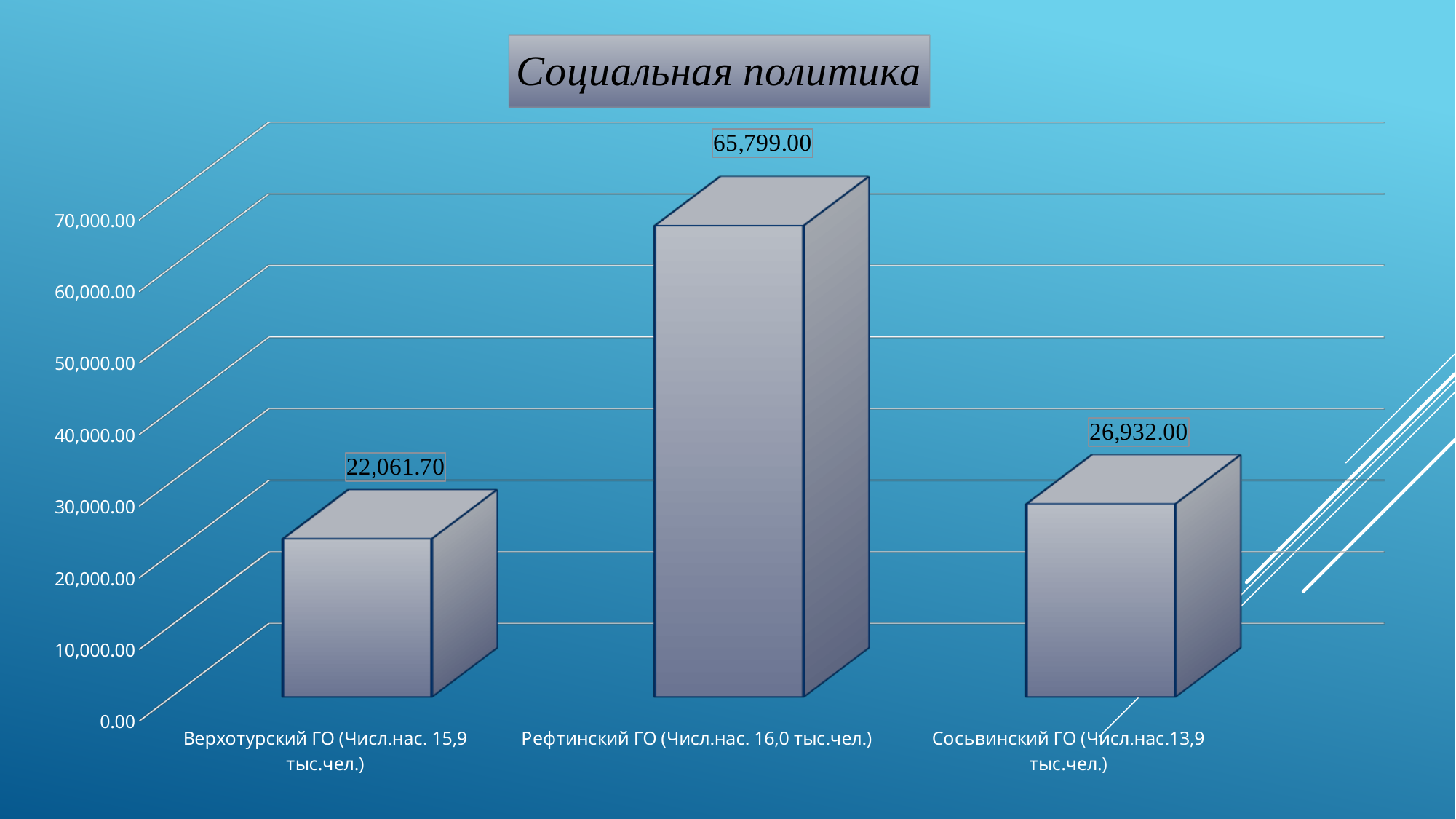
What kind of chart is shown on the slide? bar chart Which is larger, the value for Сосьвинский ГО or the value for Верхотурский ГО? Сосьвинский ГО Is the value for Рефтинский ГО greater or less than 60,000.00? greater What is the value for Сосьвинский ГО? 26,932.00 What is the title of the chart? Социальная политика How many categories are shown in the chart? 3 What is the value for Рефтинский ГО? 65,799.00 Which category has the highest value? Рефтинский ГО Which category has the lowest value? Верхотурский ГО What is the difference between the values for Рефтинский ГО and Верхотурский ГО? 43,737.30 What is the difference between the values for Сосьвинский ГО and Верхотурский ГО? 4,870.30 What is the value for Верхотурский ГО? 22,061.70